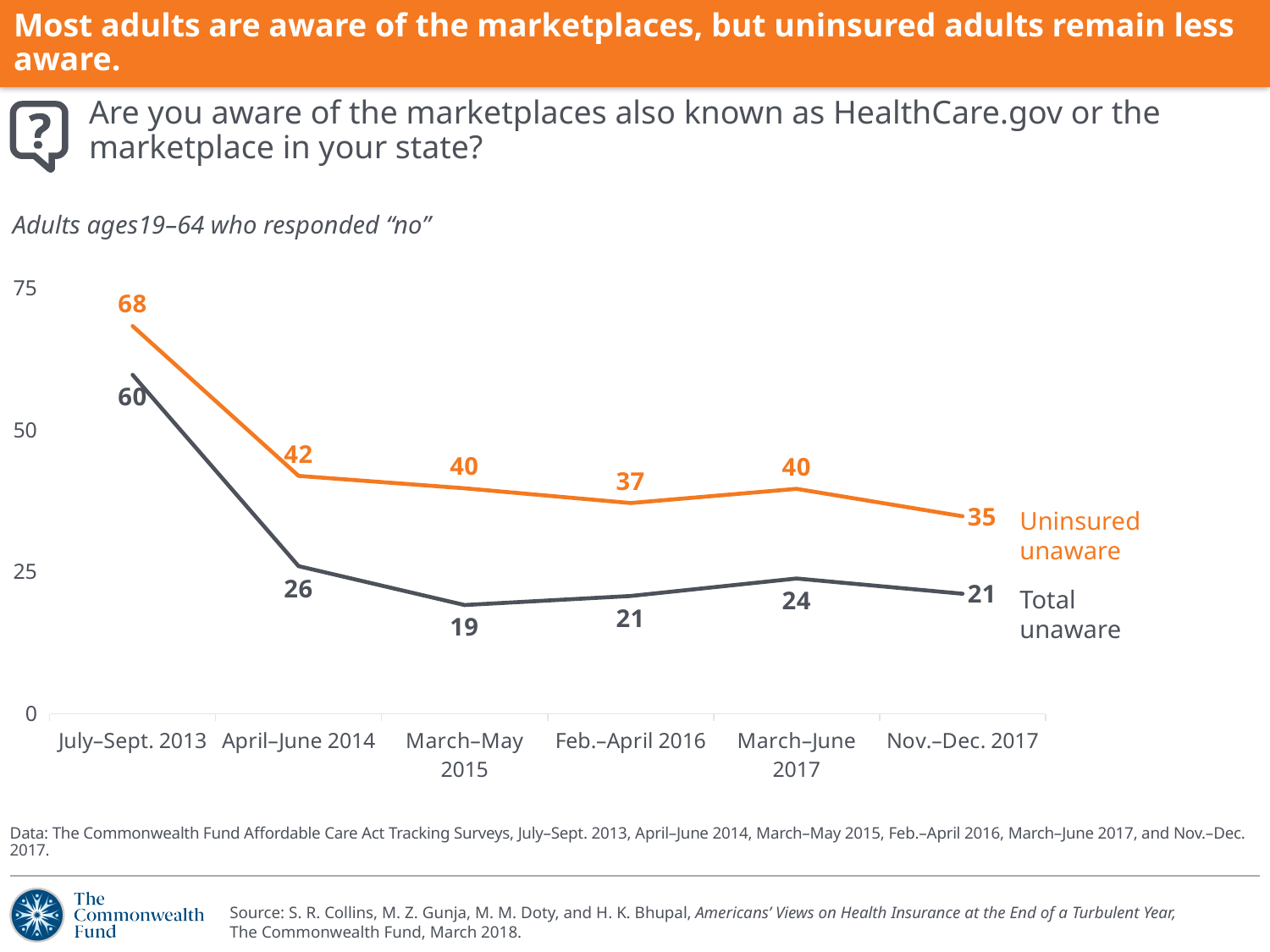
Does the Uninsured unaware line rise or fall from July–Sept. 2013 to April–June 2014? Fall In which period is the Uninsured unaware value highest? July–Sept. 2013 Which is larger in March–June 2017: Uninsured unaware or Total unaware? Uninsured unaware In which period is the Total unaware value lowest? March–May 2015 What is the value for Uninsured unaware in Nov.–Dec. 2017? 35 How many time periods are shown on the x axis? 6 What is the value for Uninsured unaware in July–Sept. 2013? 68 Is the value for Total unaware in July–Sept. 2013 greater or less than 50? greater How many series are plotted on the chart? 2 What is the value for Total unaware in March–May 2015? 19 What kind of chart is shown on the slide? Line chart What is the difference between Uninsured unaware and Total unaware in April–June 2014? 16